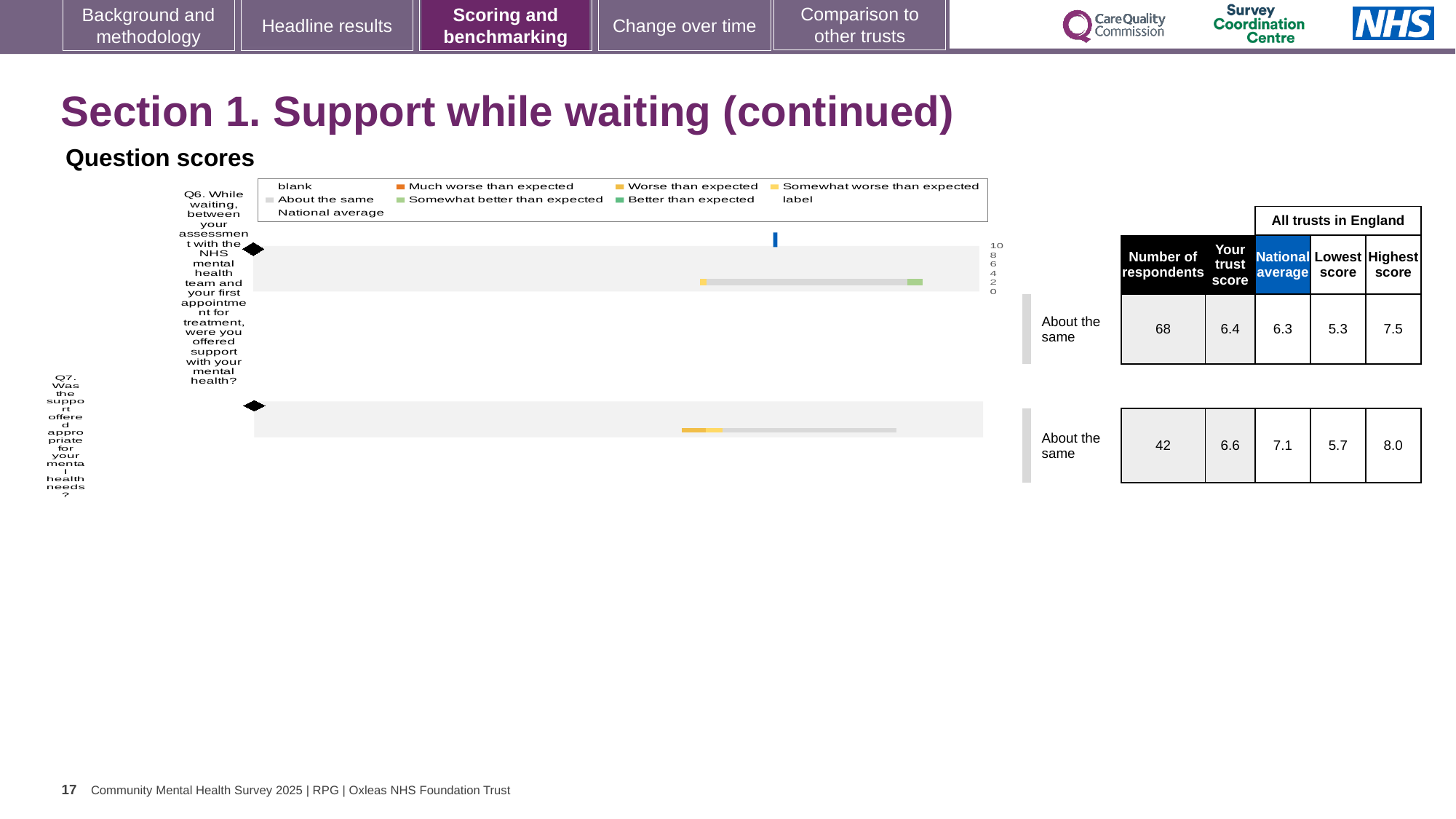
In the table beside the chart, what is the highest score among all trusts in England for Q6? 7.5 According to the table beside the chart, what is the difference between the highest and lowest trust scores in England for Q7? 2.3 In the table beside the chart, what is the trust score for Q6 (support with mental health while waiting)? 6.4 In the table beside the chart, how many respondents answered Q7? 42 In the table beside the chart, what is the national average for Q7 (was the support offered appropriate)? 7.1 How many survey questions (categories) are plotted in the question scores chart? 2 What is the maximum value shown on the score axis of the question scores chart? 10 What kind of chart is used to show the question scores on this slide? bar chart According to the table beside the chart, which question has more respondents, Q6 or Q7? Q6 What benchmark category is shown next to the chart for Q7? About the same According to the table beside the chart, is the trust score for Q6 higher or lower than the national average for Q6? higher